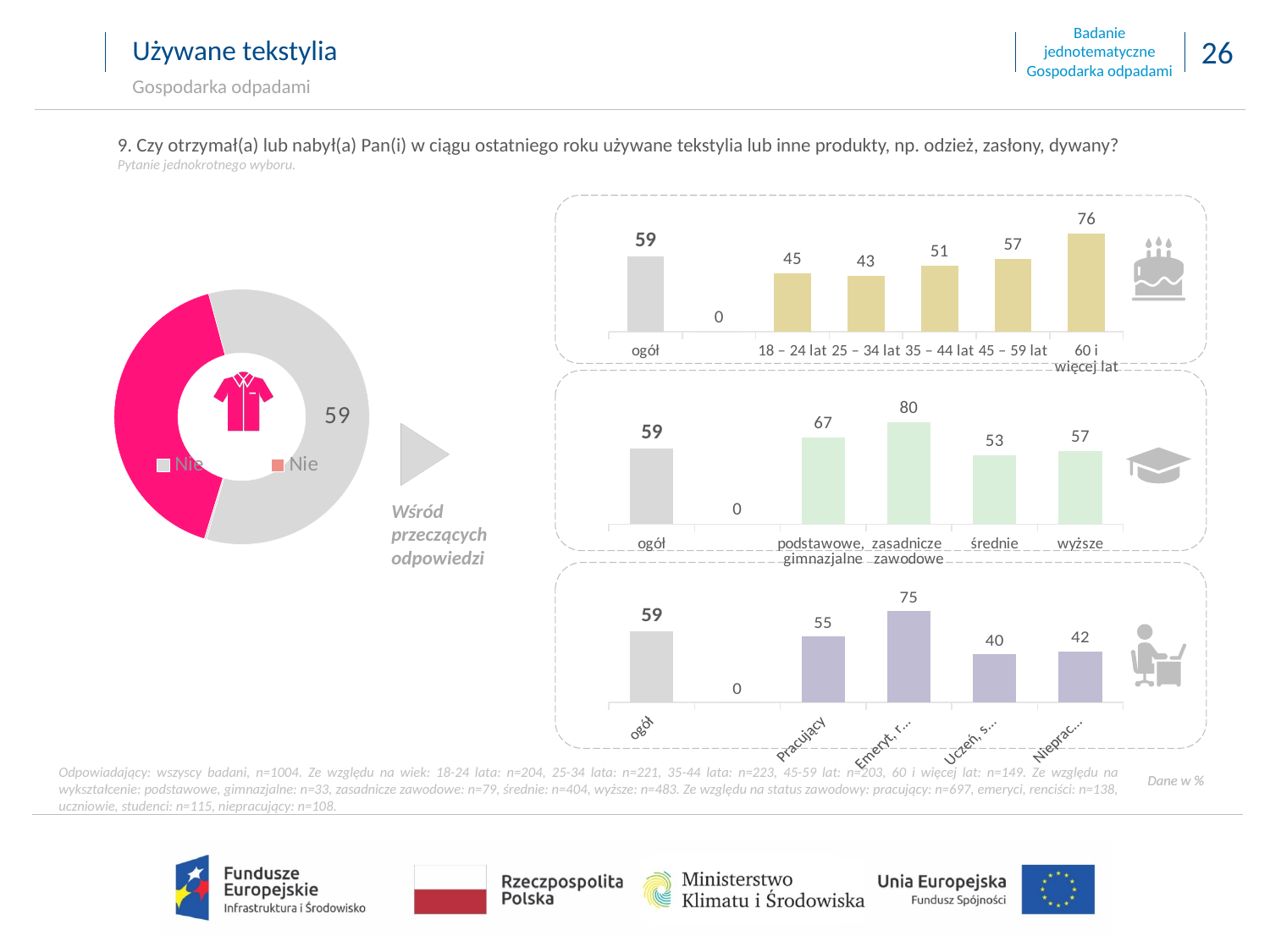
In the top bar chart on the right (by age), is the value for 45 – 59 lat larger or smaller than the value for 35 – 44 lat? larger What type of chart is shown on the left side of the slide? Donut (pie) chart In the top bar chart on the right (by age), what is the difference between the 60 i więcej lat group and the 18 – 24 lat group? 31 In the top bar chart on the right (by age), what is the value for the 60 i więcej lat group? 76 In the middle bar chart on the right (by education), what is the value for zasadnicze zawodowe? 80 In the bottom bar chart on the right (by employment status), what is the value for Pracujący? 55 In the top bar chart on the right (by age), which age group has the lowest value? 25 – 34 lat What value is shown for ogół in each of the three bar charts on the right? 59 What value is printed next to the donut chart on the left? 59 In the bottom bar chart on the right (by employment status), what is the highest value shown? 75 In the middle bar chart on the right (by education), which education category has the highest value? zasadnicze zawodowe In the middle bar chart on the right (by education), what is the difference between wyższe and średnie? 4